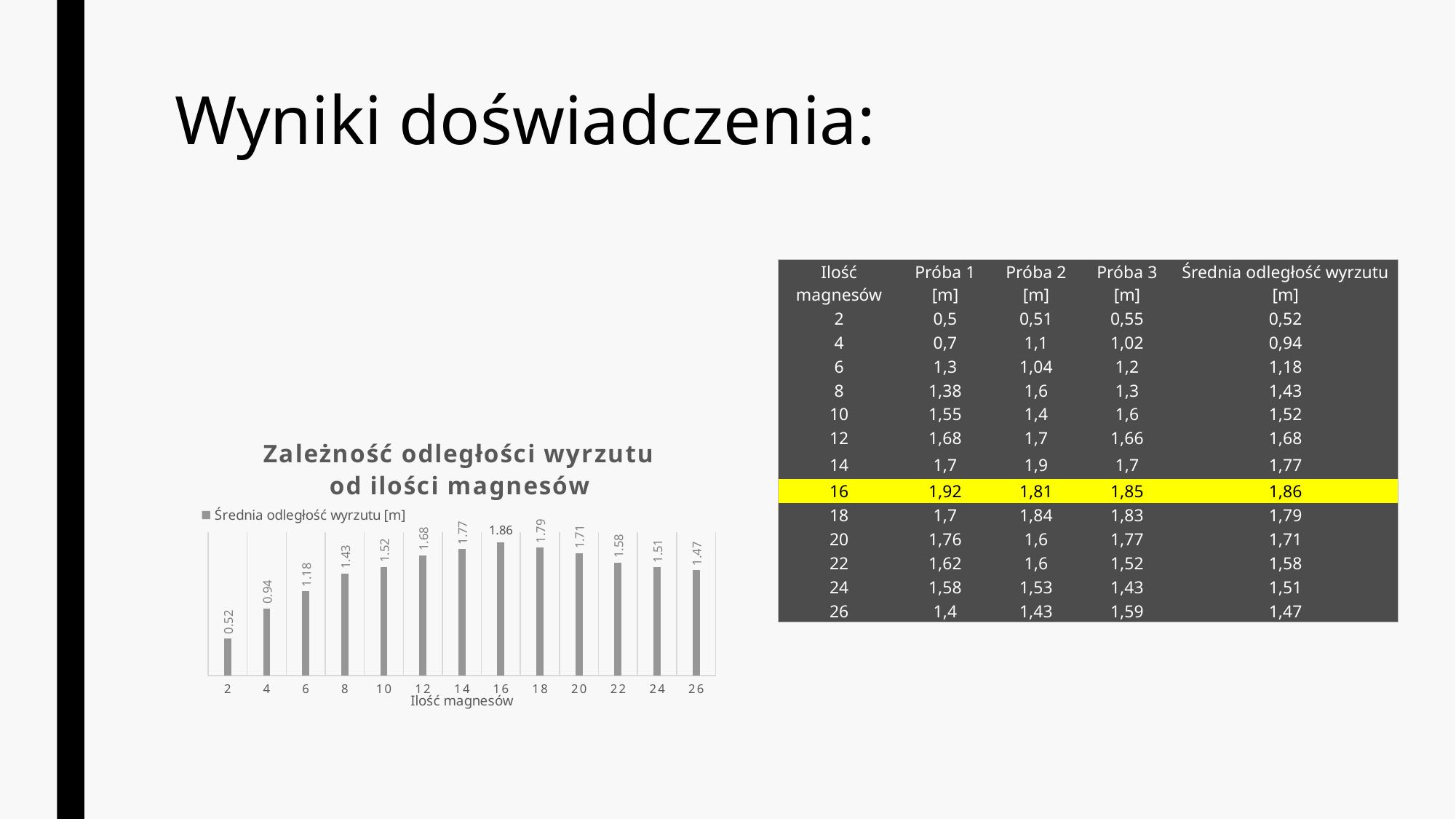
Which has a larger average throw distance: 8 magnets or 24 magnets? 24 magnets Do the values rise or fall from 2 magnets to 16 magnets along the x axis? rise How many categories (numbers of magnets) are plotted in the chart? 13 What type of chart is shown on the slide? bar chart What is the average throw distance for 26 magnets in the chart? 1.47 How many series does the chart legend list? 1 Which number of magnets has the highest average throw distance in the chart? 16 What is the difference between the average throw distance for 16 magnets and for 2 magnets? 1.34 What is the title of the chart? Zależność odległości wyrzutu od ilości magnesów What is the average throw distance for 16 magnets in the chart? 1.86 What is the average throw distance for 2 magnets in the chart? 0.52 Which number of magnets has the lowest average throw distance in the chart? 2